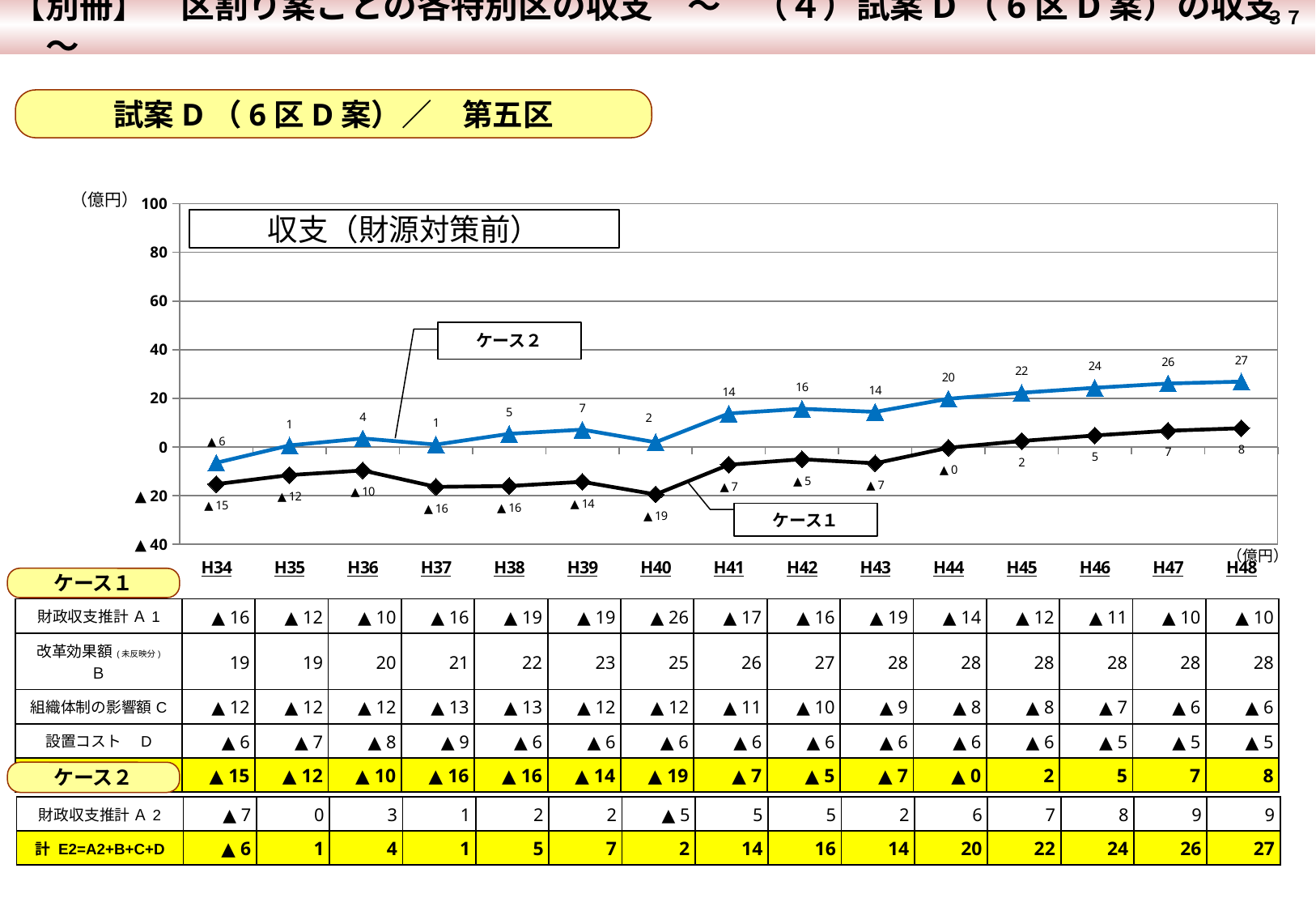
What type of chart is shown on the slide? line chart How many years (x-axis categories) are plotted in the chart? 15 At which year does ケース1 reach its lowest value? H40 Which series has the larger value at H42, ケース1 or ケース2? ケース2 What is the title of the chart? 収支（財源対策前） What is the value of ケース2 at H41? 14 What is the difference between ケース2 and ケース1 at H48? 19 At which year does ケース2 reach its highest value? H48 How many series are plotted in the chart? 2 What is the value of ケース2 at H48? 27 What is the value of ケース1 at H40? ▲19 Does ケース2 generally rise or fall from H41 to H48? rise